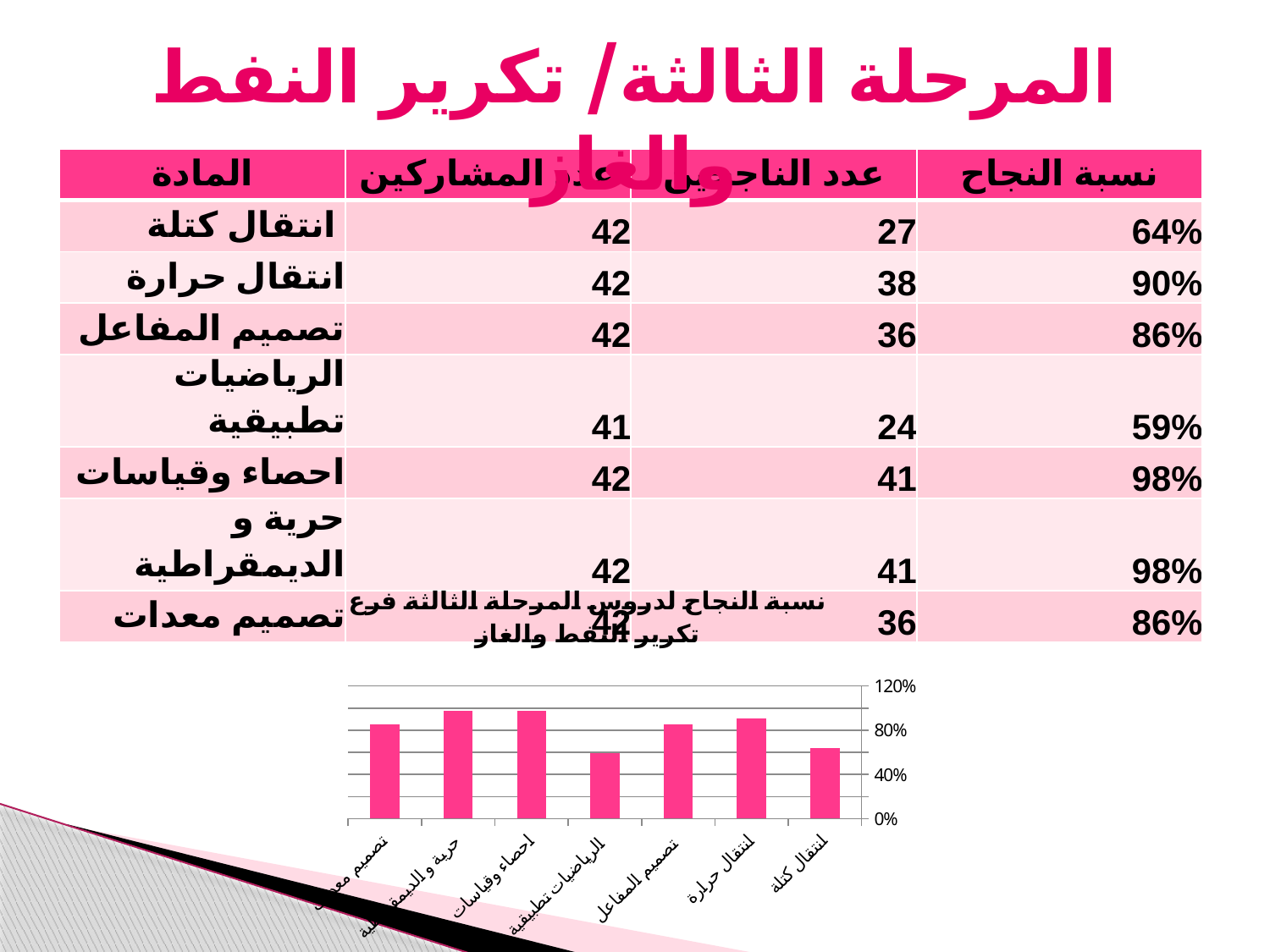
In the bar chart, is the value for احصاء وقياسات greater or less than 80%? greater In the bar chart, is the value for انتقال حرارة greater or less than 80%? greater Which subject has the lowest bar in the chart? الرياضيات تطبيقية What kind of chart is shown at the bottom of the slide? bar chart What is the highest value shown on the vertical axis of the bar chart? 120% What is the title of the bar chart? نسبة النجاح لدروس المرحلة الثالثة فرع تكرير النفط والغاز In the bar chart, which is larger: the value for احصاء وقياسات or the value for الرياضيات تطبيقية? احصاء وقياسات How many categories (subjects) are plotted on the bar chart? 7 In the bar chart, which is larger: the value for انتقال حرارة or the value for انتقال كتلة? انتقال حرارة In the bar chart, is the value for انتقال كتلة greater or less than 80%? less